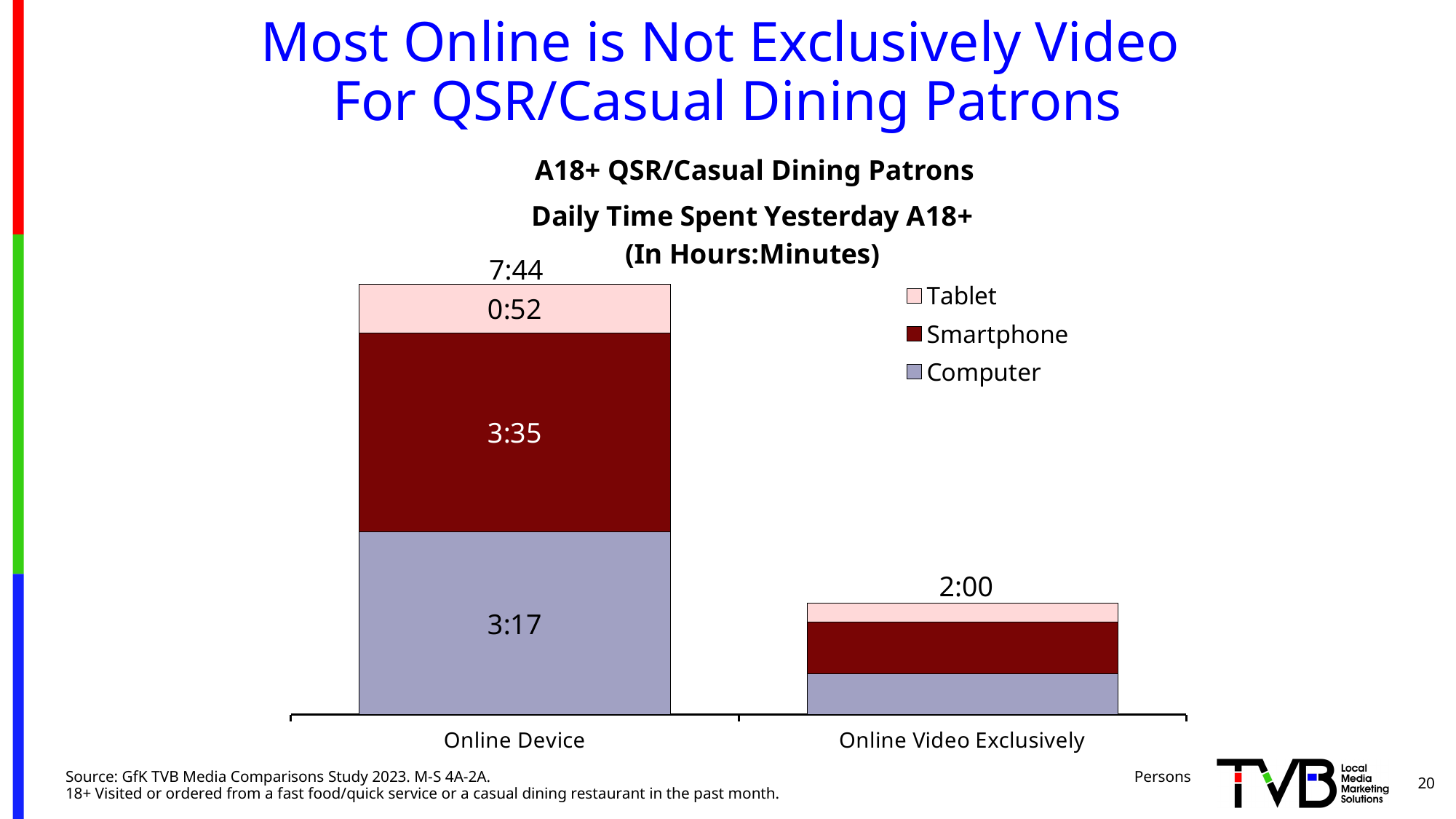
What type of chart is shown on the slide? Stacked bar chart What is the total daily time spent for Online Device? 7:44 Which device accounts for the smallest share of the Online Device bar? Tablet What is the difference between the Smartphone and Computer values for Online Device? 0:18 What is the difference between the Online Device total and the Online Video Exclusively total? 5:44 How many categories are shown on the x axis? 2 What is the Smartphone value for Online Device? 3:35 How many series does the legend list? 3 What is the Tablet value for Online Device? 0:52 Which device accounts for the largest share of the Online Device bar? Smartphone What is the total daily time spent for Online Video Exclusively? 2:00 What is the Computer value for Online Device? 3:17